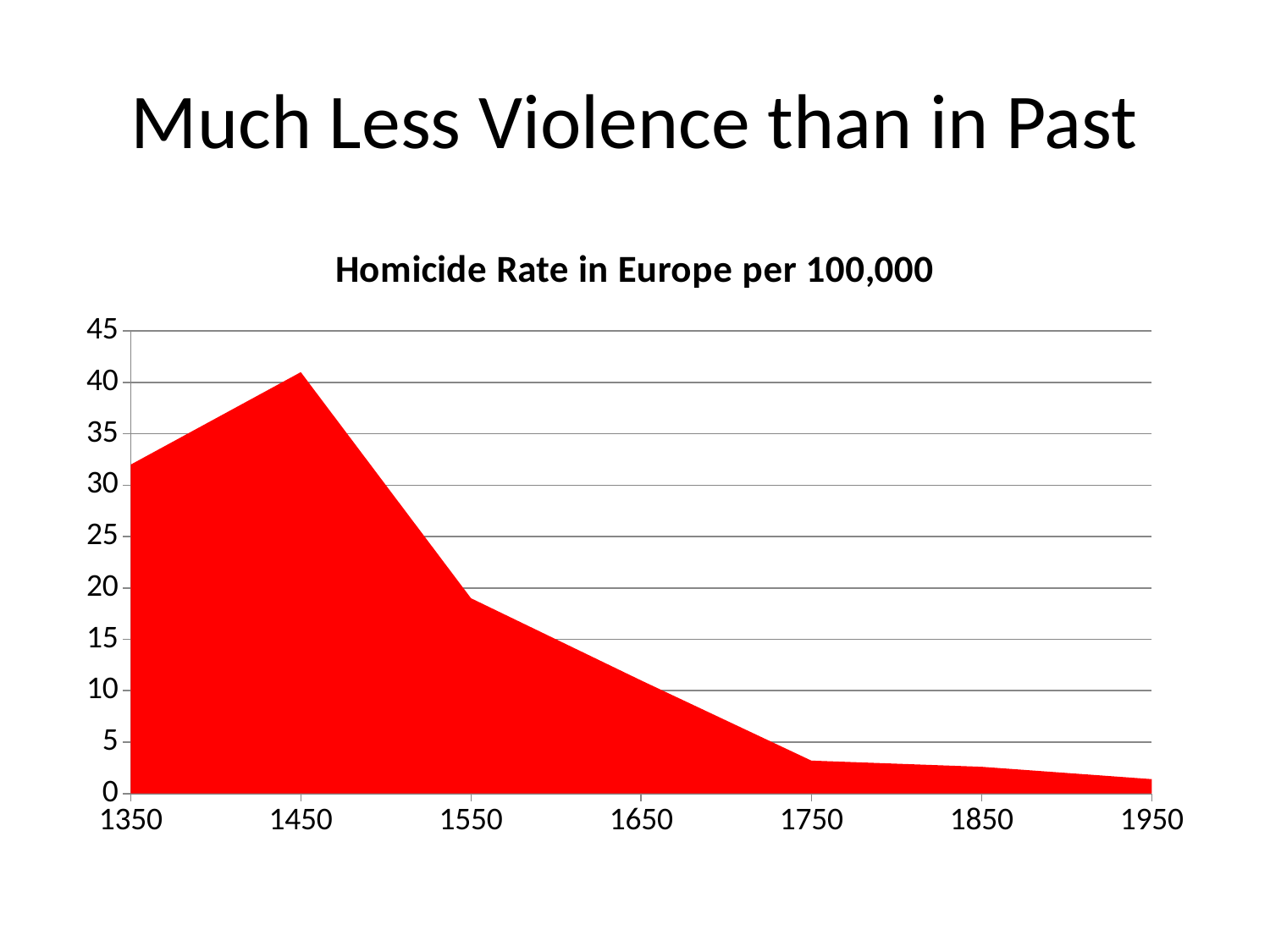
Is the homicide rate for 1750 greater or less than 5? less What colour is the filled area in the chart? red What is the title of the chart? Homicide Rate in Europe per 100,000 Is the homicide rate for 1350 greater or less than 30? greater Which year has a higher homicide rate, 1350 or 1550? 1350 Do the values rise or fall along the x axis from 1450 to 1950? fall What kind of chart is shown on the slide? area chart Is the homicide rate for 1450 greater or less than 40? greater Which year has the highest homicide rate in the chart? 1450 How many years are labelled along the x axis of the chart? 7 Which year has the lowest homicide rate in the chart? 1950